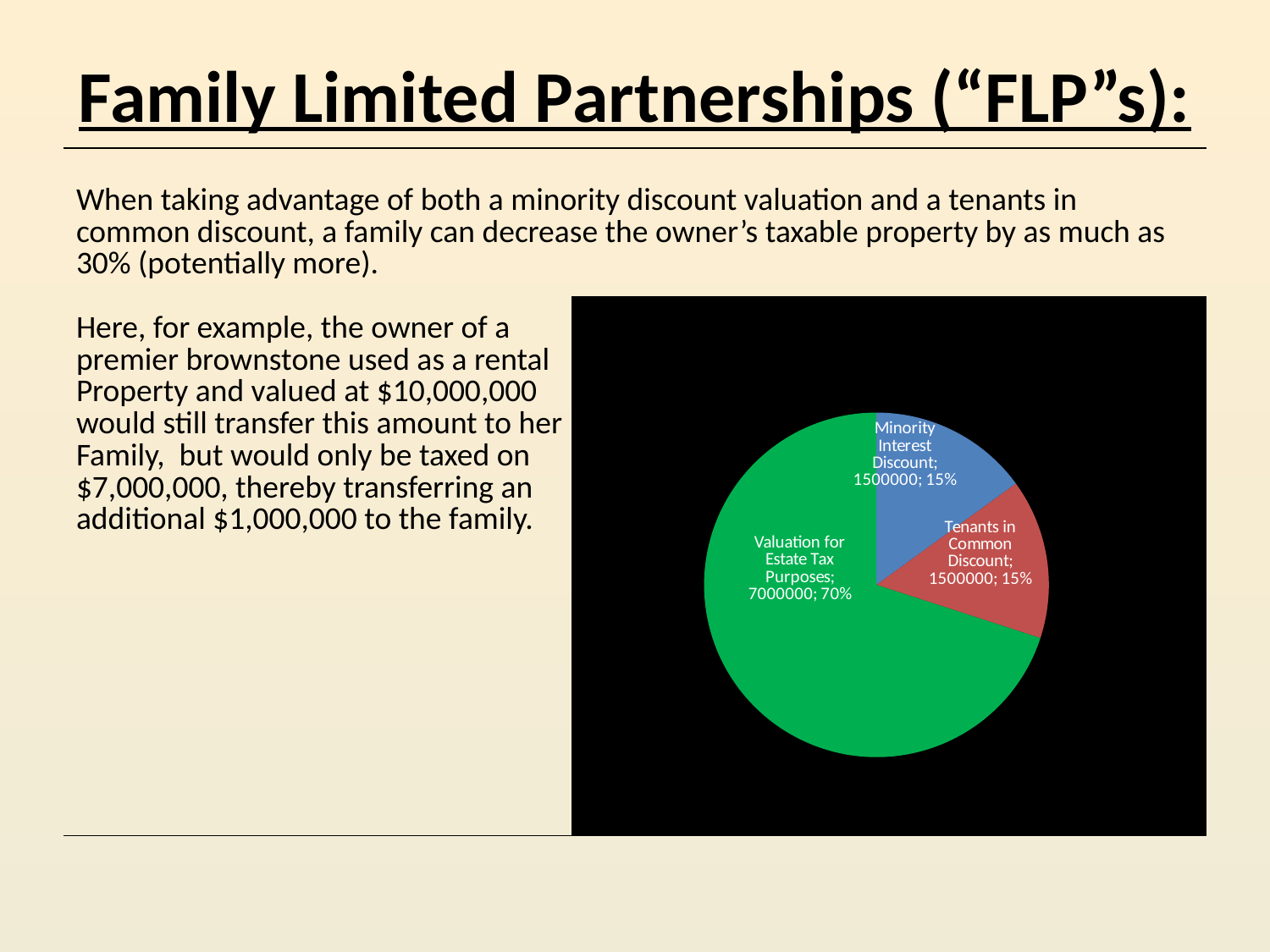
What is the value of the Valuation for Estate Tax Purposes slice? 7000000 What is the difference between the Valuation for Estate Tax Purposes value and the Minority Interest Discount value? 5500000 What is the combined share of the Minority Interest Discount and Tenants in Common Discount slices? 30% Which is larger, the Valuation for Estate Tax Purposes slice or the Tenants in Common Discount slice? Valuation for Estate Tax Purposes How many slices does the pie chart have? 3 What kind of chart is shown on the slide? pie chart What is the value of the Minority Interest Discount slice? 1500000 What share of the pie does the Tenants in Common Discount slice represent? 15% What is the value of the Tenants in Common Discount slice? 1500000 What colour is the Valuation for Estate Tax Purposes slice? green Which slice of the pie chart is the largest? Valuation for Estate Tax Purposes What share of the pie does the Valuation for Estate Tax Purposes slice represent? 70%